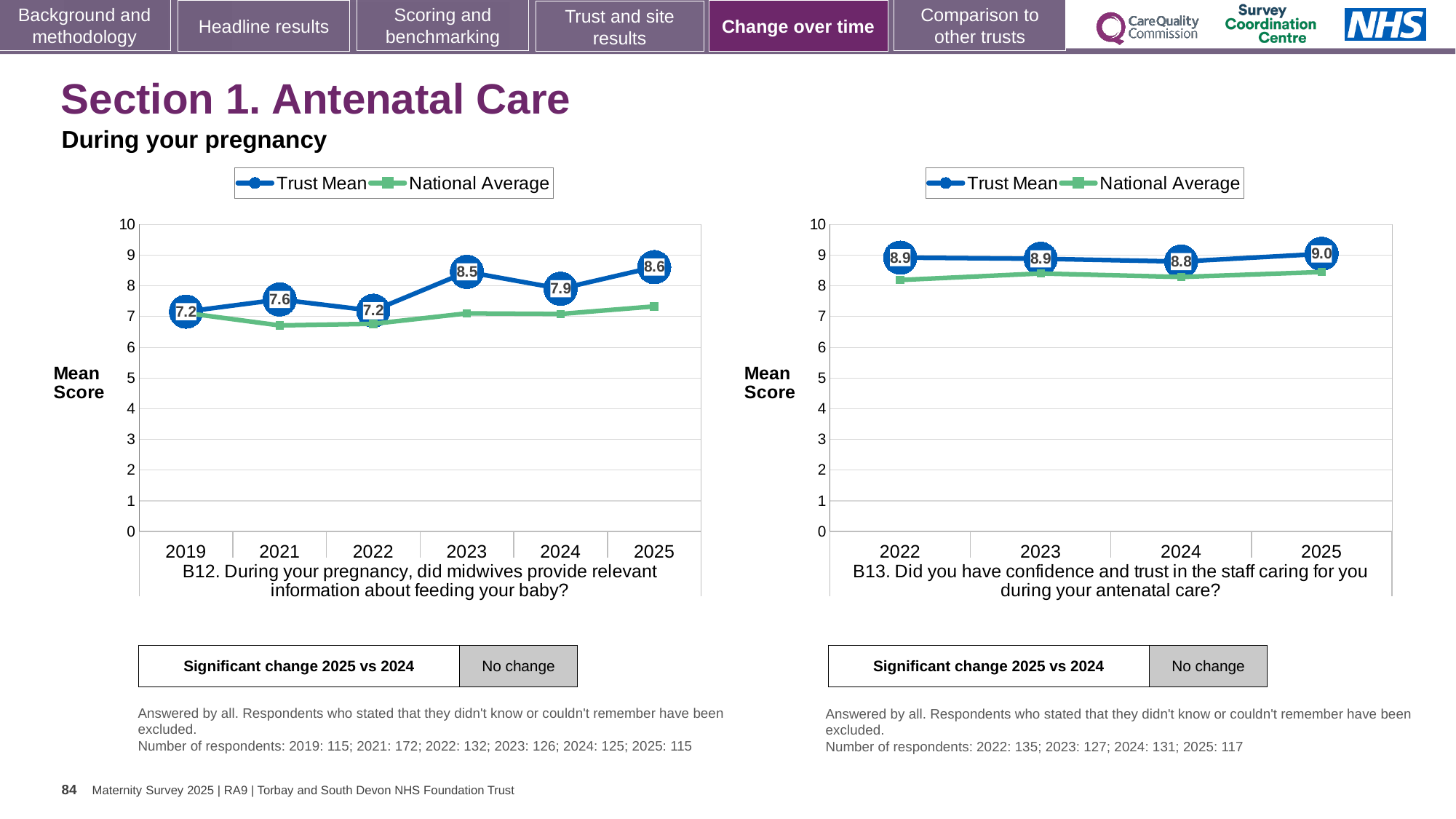
In the B12 chart on the left, what is the difference between the Trust Mean in 2025 and in 2024? 0.7 How many series does the legend of the B13 chart on the right list? 2 In the B12 chart on the left, what is the Trust Mean for 2023? 8.5 In the B12 chart on the left, is the National Average for 2021 greater or less than 7? less What type of chart is the B13 chart on the right? Line chart In the B13 chart on the right, what is the Trust Mean for 2025? 9.0 In the B13 chart on the right, which year has the lowest Trust Mean? 2024 In the B12 chart on the left, which year has the highest Trust Mean? 2025 In the B12 chart on the left, is the Trust Mean for 2021 larger or smaller than the Trust Mean for 2022? larger In the B13 chart on the right, is the National Average for 2022 greater or less than 9? less In the B12 chart on the left, what is the Trust Mean for 2025? 8.6 How many years are shown on the x axis of the B12 chart on the left? 6